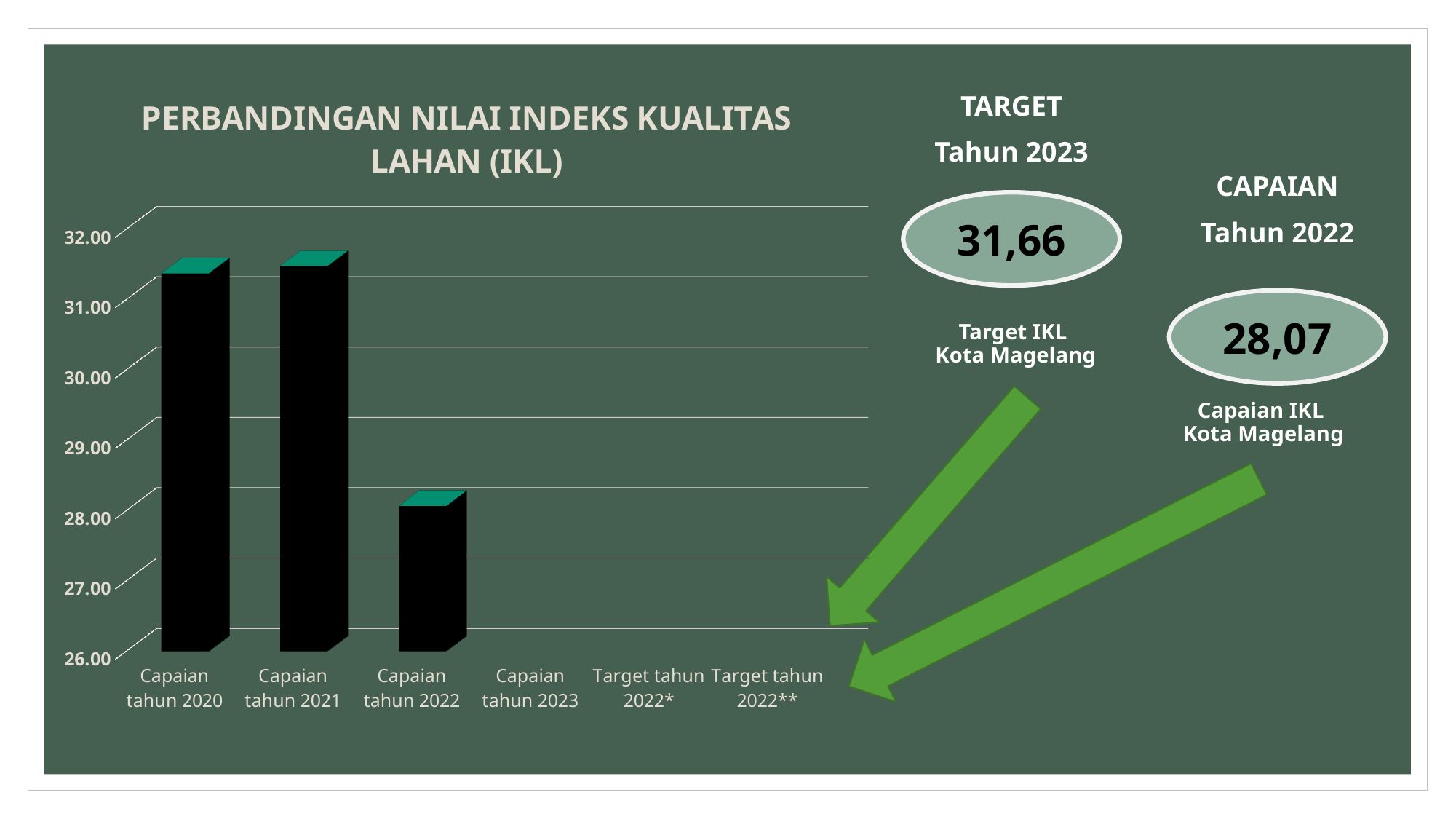
How many categories are labelled on the x axis of the chart? 6 Is the value for Capaian tahun 2021 greater or less than 32.00? less What kind of chart is shown on the slide? Bar chart How many bars are actually plotted in the chart? 3 Which plotted category has the lowest bar in the chart? Capaian tahun 2022 Does the value rise or fall from Capaian tahun 2021 to Capaian tahun 2022? fall Which is larger, the bar for Capaian tahun 2020 or the bar for Capaian tahun 2022? Capaian tahun 2020 Is the value for Capaian tahun 2020 greater or less than 31.00? greater What is the lowest value shown on the y axis of the chart? 26.00 What is the title of the chart? PERBANDINGAN NILAI INDEKS KUALITAS LAHAN (IKL) Is the value for Capaian tahun 2022 greater or less than 29.00? less